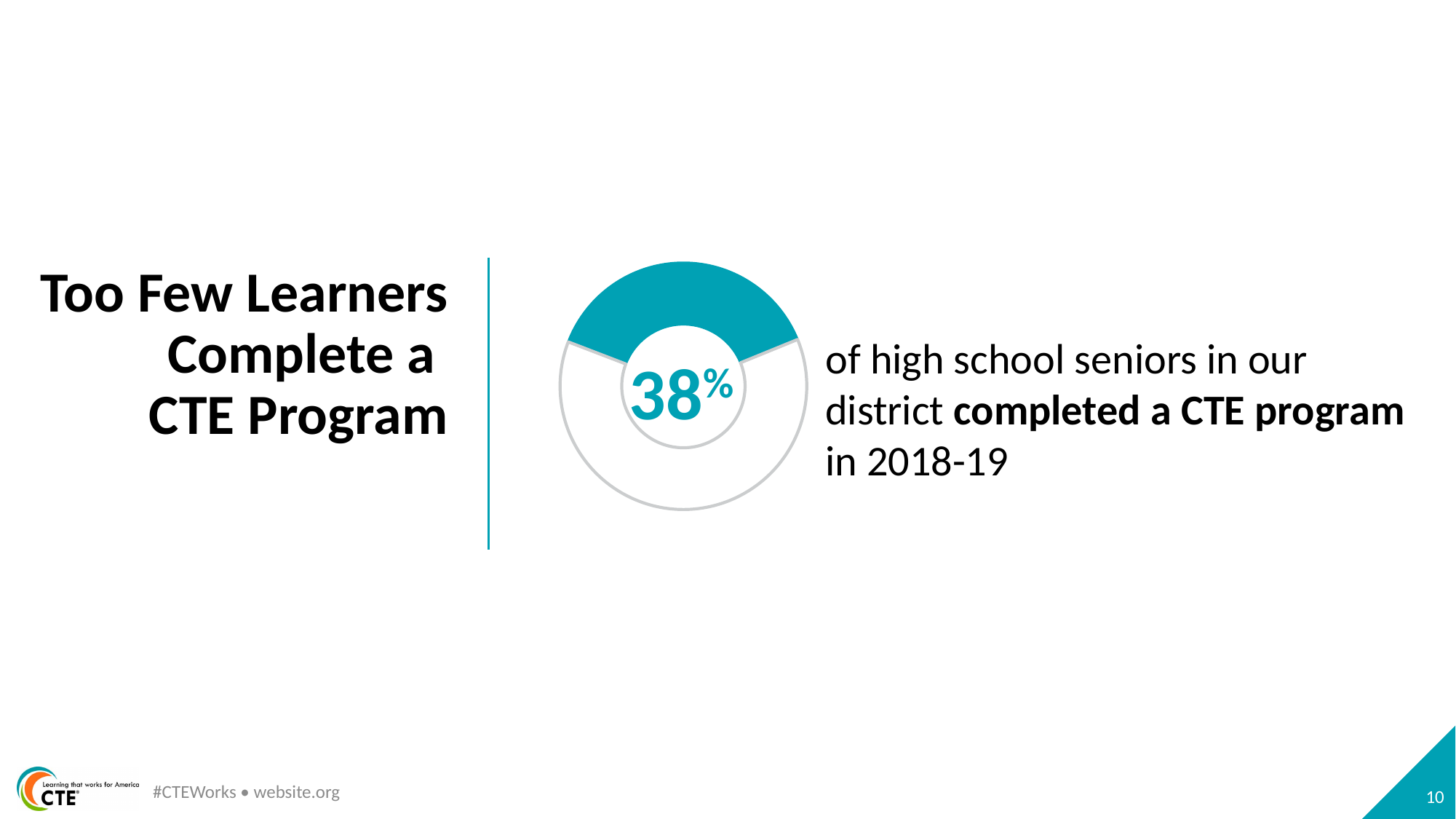
How many segments does the donut chart have? 2 Is the filled (teal) portion of the donut chart greater or less than 50%? less What colour is the filled portion of the donut chart? teal Which school year does the 38% figure in the chart refer to? 2018-19 Which portion of the donut chart is larger, the teal filled portion or the white unfilled portion? the white unfilled portion What is the title of the slide containing the donut chart? Too Few Learners Complete a CTE Program What share of the donut chart is left unfilled (white)? 62% What percentage is printed in the centre of the donut chart? 38% What kind of chart is shown on the slide? donut chart What share of high school seniors in the district completed a CTE program in 2018-19, according to the chart? 38%